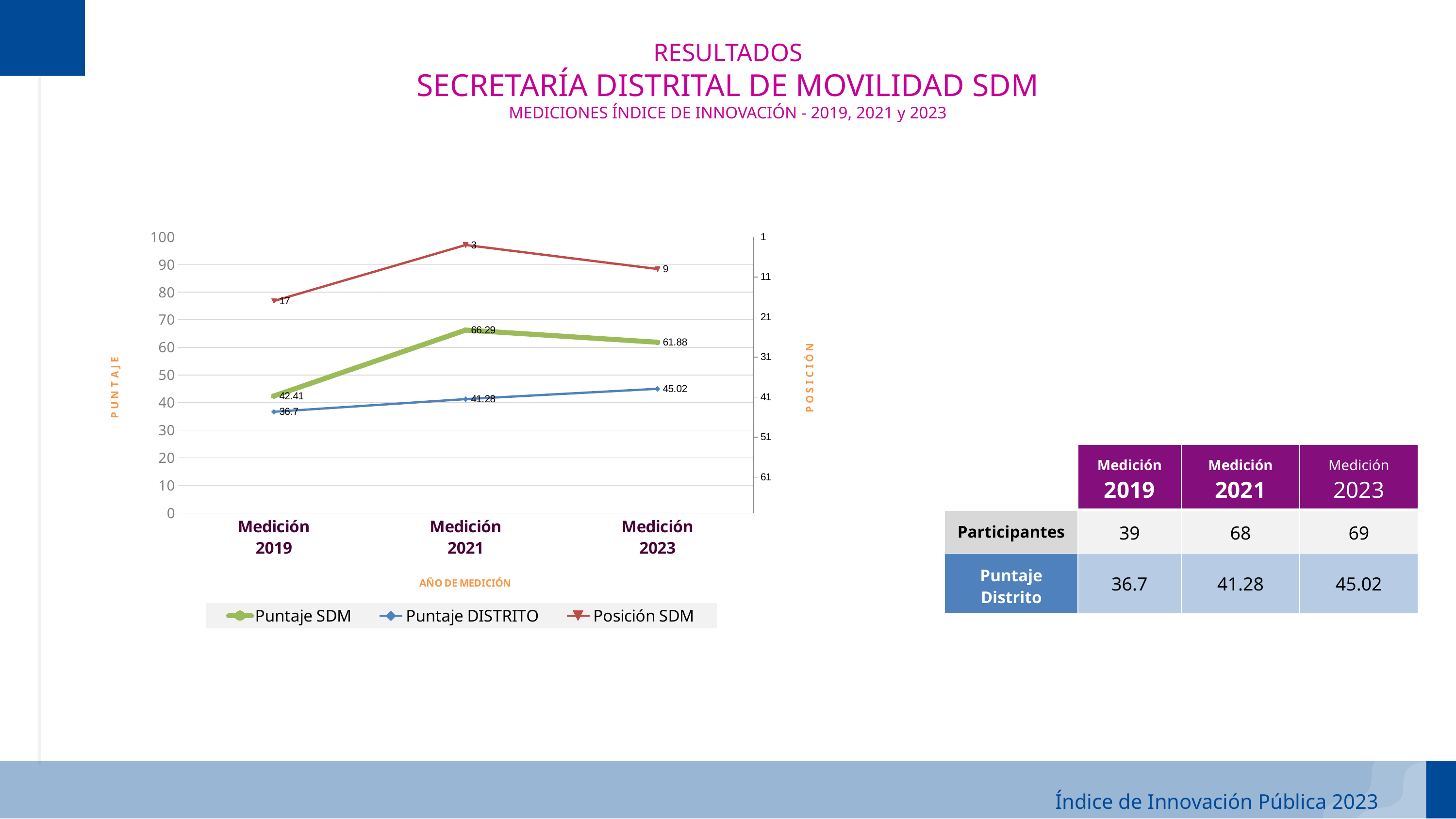
What is the Puntaje SDM value for Medición 2021? 66.29 What kind of chart is shown on the slide? Line chart In which measurement year is Puntaje SDM highest? Medición 2021 What is the Posición SDM value for Medición 2023? 9 Which is larger in Medición 2019: Puntaje SDM or Puntaje DISTRITO? Puntaje SDM What is the label of the right-hand vertical axis? POSICIÓN How many series does the legend list? 3 What is the difference between Puntaje SDM and Puntaje DISTRITO in Medición 2023? 16.86 How many measurement years are shown on the x axis? 3 In which measurement year is Puntaje DISTRITO lowest? Medición 2019 What is the Puntaje DISTRITO value for Medición 2019? 36.7 Does Puntaje DISTRITO rise or fall from Medición 2019 to Medición 2023? Rise